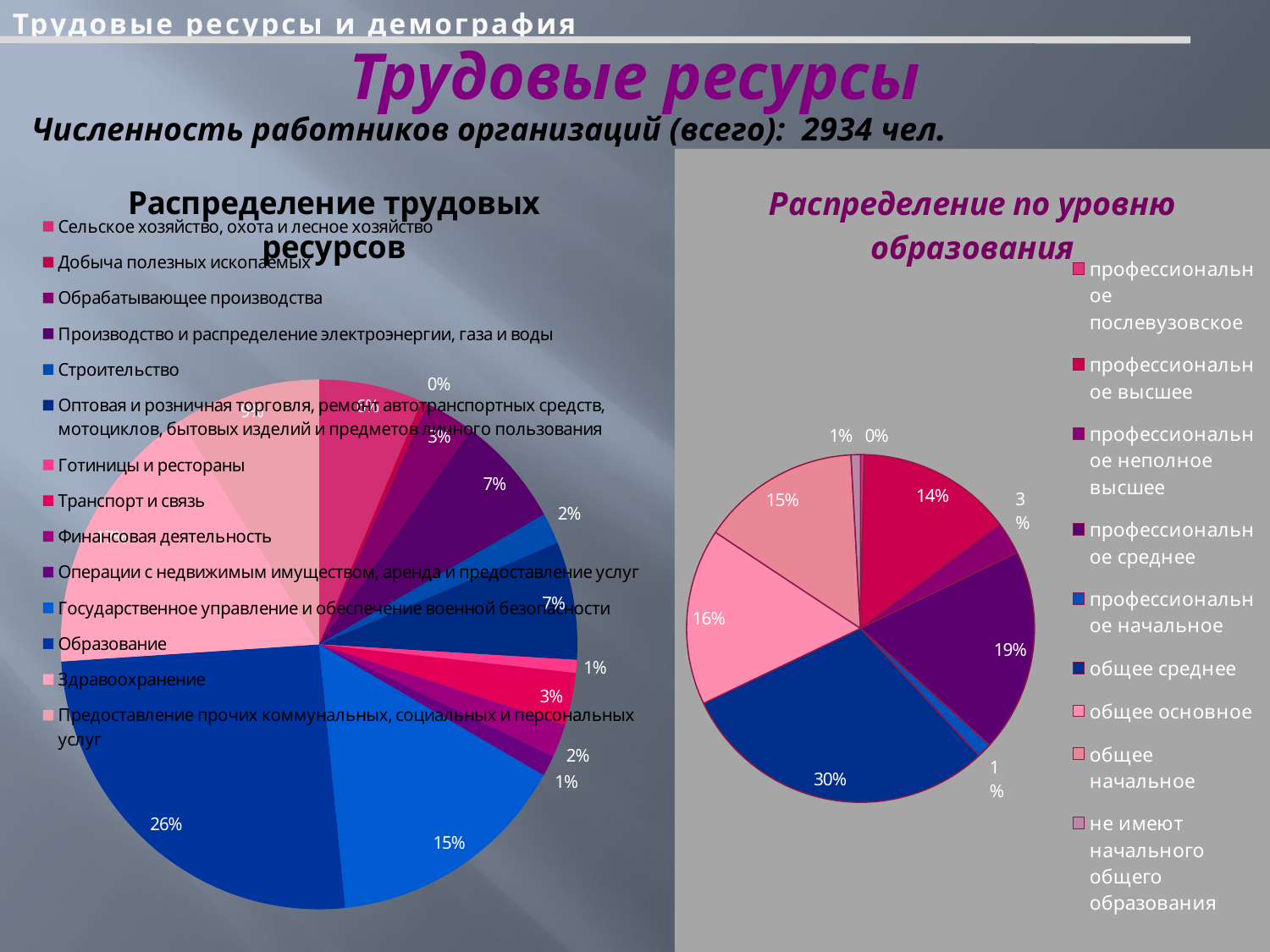
In the 'Распределение по уровню образования' chart, what share is 'общее основное'? 16% In the 'Распределение по уровню образования' chart, what share is 'общее среднее'? 30% In the 'Распределение трудовых ресурсов' chart, what is the largest percentage labelled on a slice? 26% How many categories does the legend of the 'Распределение по уровню образования' chart list? 9 What kind of chart is the 'Распределение по уровню образования' chart? pie chart How many categories does the legend of the 'Распределение трудовых ресурсов' chart list? 14 In the 'Распределение по уровню образования' chart, which is larger: 'общее основное' or 'общее начальное'? общее основное In the 'Распределение по уровню образования' chart, what share is 'профессиональное неполное высшее'? 3% In the 'Распределение по уровню образования' chart, what is the difference in percentage points between 'общее среднее' and 'профессиональное среднее'? 11 percentage points In the 'Распределение по уровню образования' chart, what share is 'профессиональное среднее'? 19% In the 'Распределение по уровню образования' chart, which category has the largest share? общее среднее In the 'Распределение по уровню образования' chart, what share is 'профессиональное высшее'? 14%